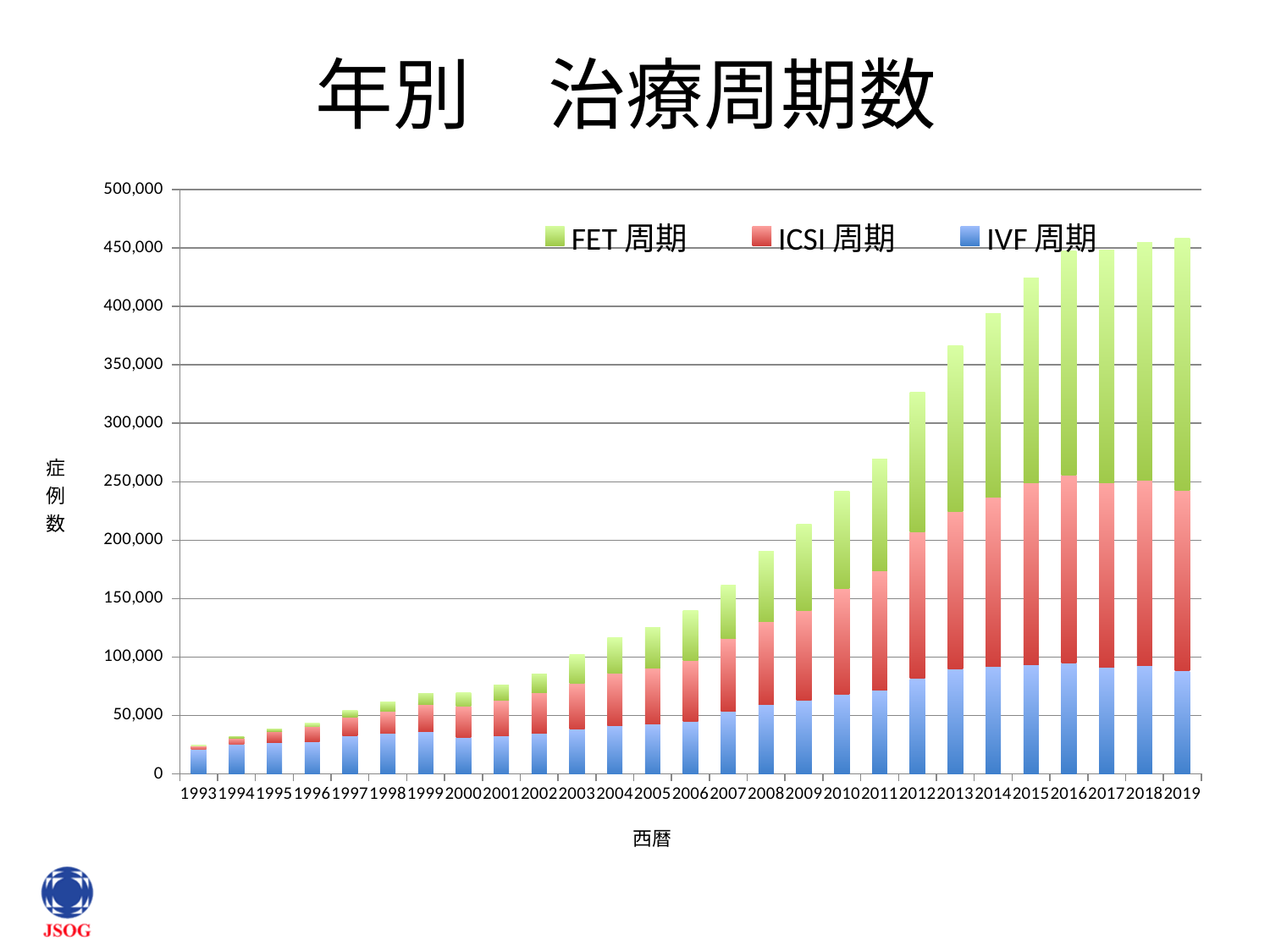
How many years are shown along the x axis of the chart? 27 What is the title of the chart? 年別 治療周期数 Which series is shown in green in the chart's legend? FET 周期 Is the total value for 2013 greater or less than 350,000? greater How many series does the chart's legend list? 3 Is the total value for 1993 greater or less than 50,000? less What kind of chart is shown on the slide? stacked bar chart Which year has the lowest total number of treatment cycles? 1993 Is the total value for 2012 greater or less than 300,000? greater Do the total treatment cycles generally rise or fall from 1993 to 2019? rise Which year has the larger total number of treatment cycles, 2005 or 2010? 2010